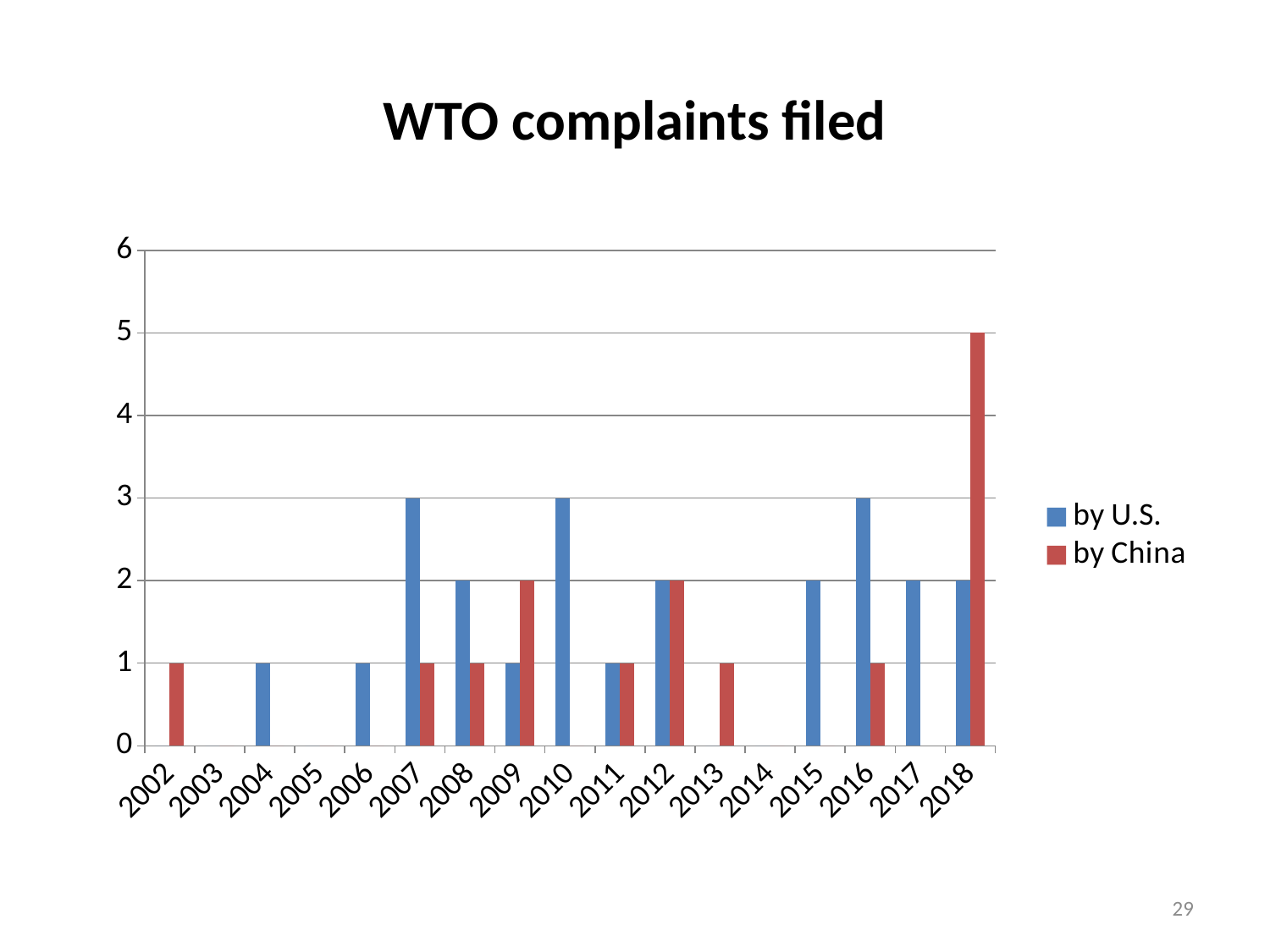
What is the title of the chart? WTO complaints filed In 2016, which filed more WTO complaints, the U.S. or China? the U.S. Is the value for complaints filed by China in 2018 greater or less than 4? greater How many WTO complaints were filed by China in 2018? 5 Which colour represents complaints filed by China? red How many years are shown on the x axis? 17 What kind of chart is shown on the slide? bar chart How many WTO complaints were filed by China in 2009? 2 What is the difference between complaints filed by China and by the U.S. in 2018? 3 In which year did China file the most WTO complaints? 2018 How many WTO complaints were filed by the U.S. in 2007? 3 How many series does the legend list? 2